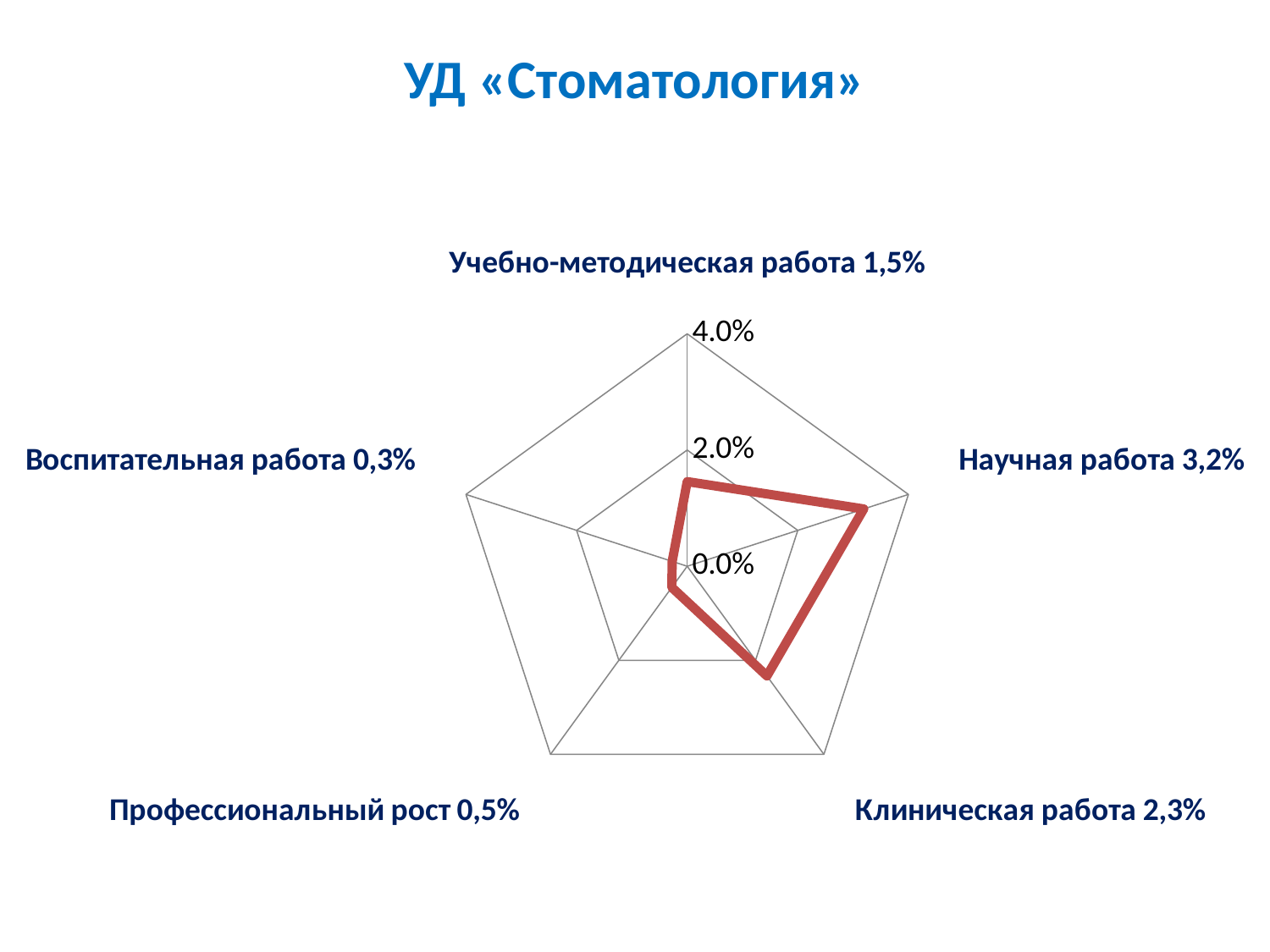
What is the value for Воспитательная работа? 0,3% What is the value for Клиническая работа? 2,3% What is the title of the slide? УД «Стоматология» Is the value for Научная работа greater or less than 2.0%? greater What is the value for Научная работа? 3,2% How many categories (axes) does the radar chart have? 5 Which category has the lowest value? Воспитательная работа What is the value for Учебно-методическая работа? 1,5% Which category has the highest value? Научная работа Which is larger, the value for Учебно-методическая работа or Профессиональный рост? Учебно-методическая работа What type of chart is shown on the slide? Radar chart What is the difference between the values for Научная работа and Клиническая работа? 0,9%